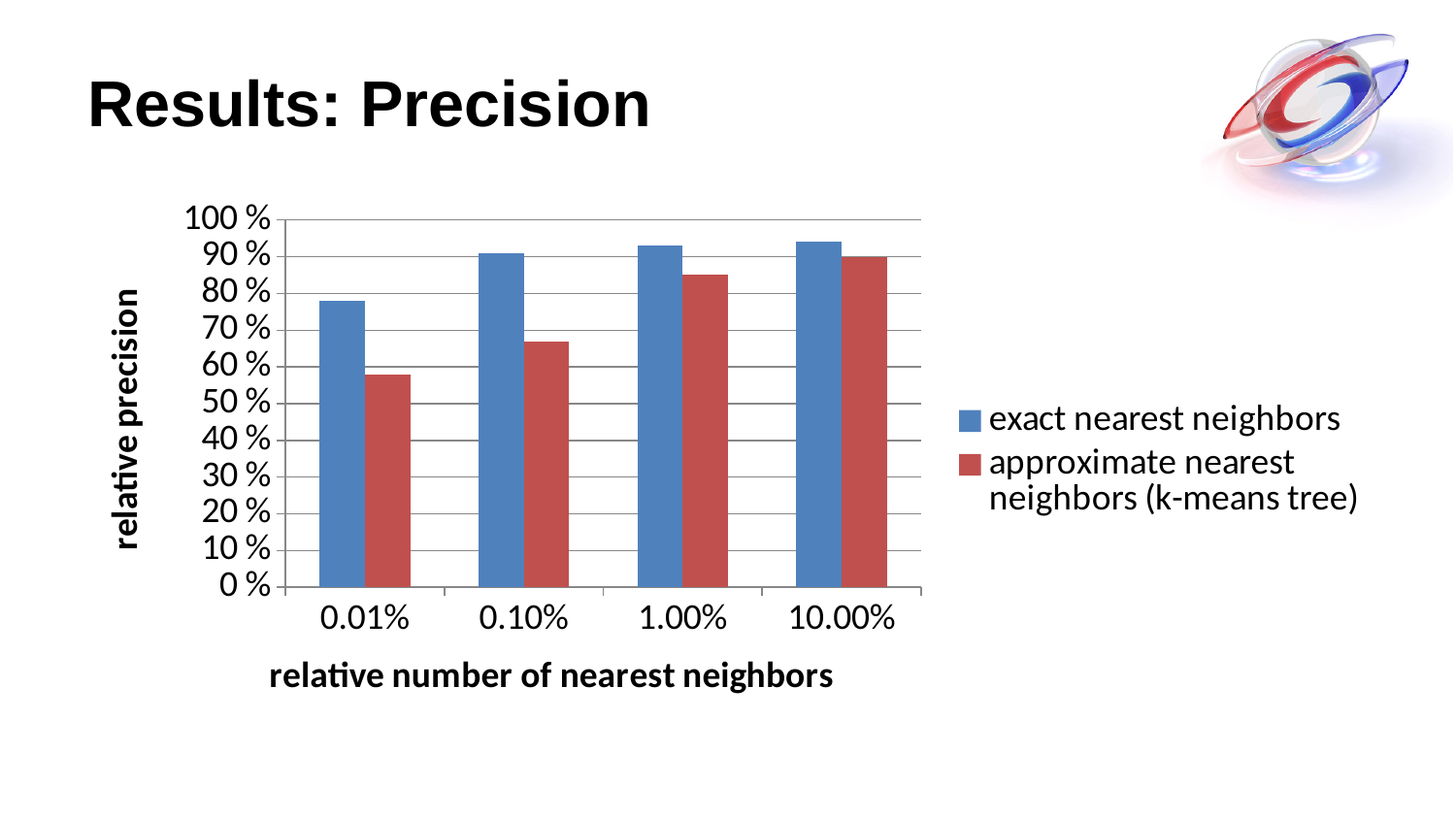
Is the value for approximate nearest neighbors (k-means tree) at 0.10% greater or less than 70 %? less For which category is the approximate nearest neighbors (k-means tree) value highest? 10.00% How many series does the legend list? 2 At 0.01%, which series has the larger value: exact nearest neighbors or approximate nearest neighbors (k-means tree)? exact nearest neighbors Is the value for approximate nearest neighbors (k-means tree) at 0.01% greater or less than 50 %? greater Is the value for exact nearest neighbors at 0.10% greater or less than 80 %? greater What kind of chart is shown on the slide? bar chart How many categories are shown on the x axis? 4 Do the approximate nearest neighbors (k-means tree) values rise or fall as the relative number of nearest neighbors increases along the x axis? rise For which category is the approximate nearest neighbors (k-means tree) value lowest? 0.01%